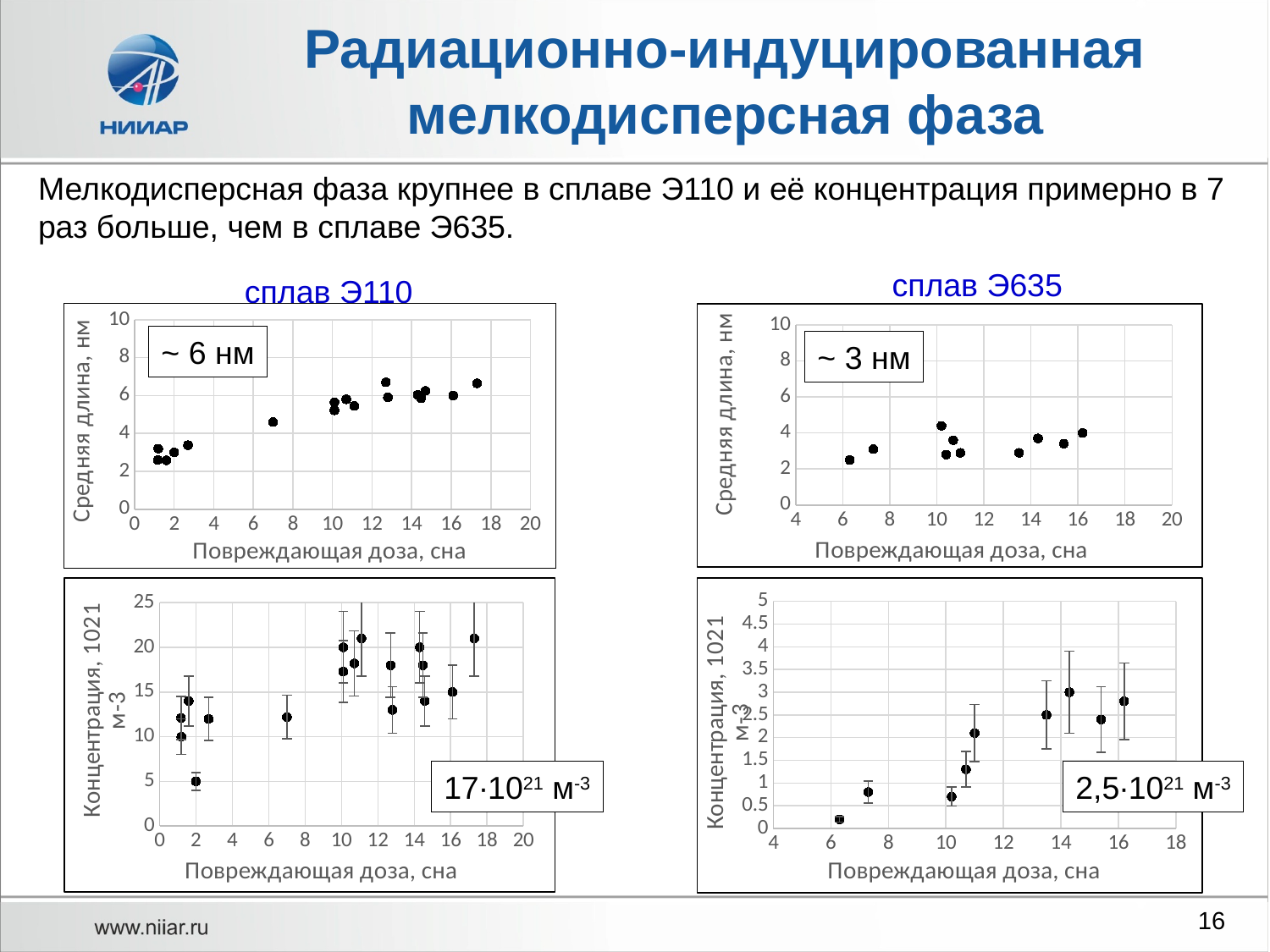
What kind of chart is the top-left chart titled "сплав Э110"? scatter chart In the top-right chart (сплав Э635, средняя длина), is the value at a dose of about 6 сна greater or less than 4 нм? less In the top-left chart (сплав Э110, средняя длина), is the value at a dose of about 7 сна greater or less than 4 нм? greater In the top-left chart (сплав Э110, средняя длина), is the value at a dose of about 1 сна greater or less than 4 нм? less In the top-left chart (сплав Э110, средняя длина), do the values generally rise or fall as the damaging dose increases? rise What annotation is shown in the box on the top-left chart (сплав Э110, средняя длина)? ~ 6 нм What is the x-axis label of the bottom-left chart (сплав Э110, концентрация)? Повреждающая доза, сна In the bottom-right chart (сплав Э635, концентрация), do the values generally rise or fall as the damaging dose increases? rise